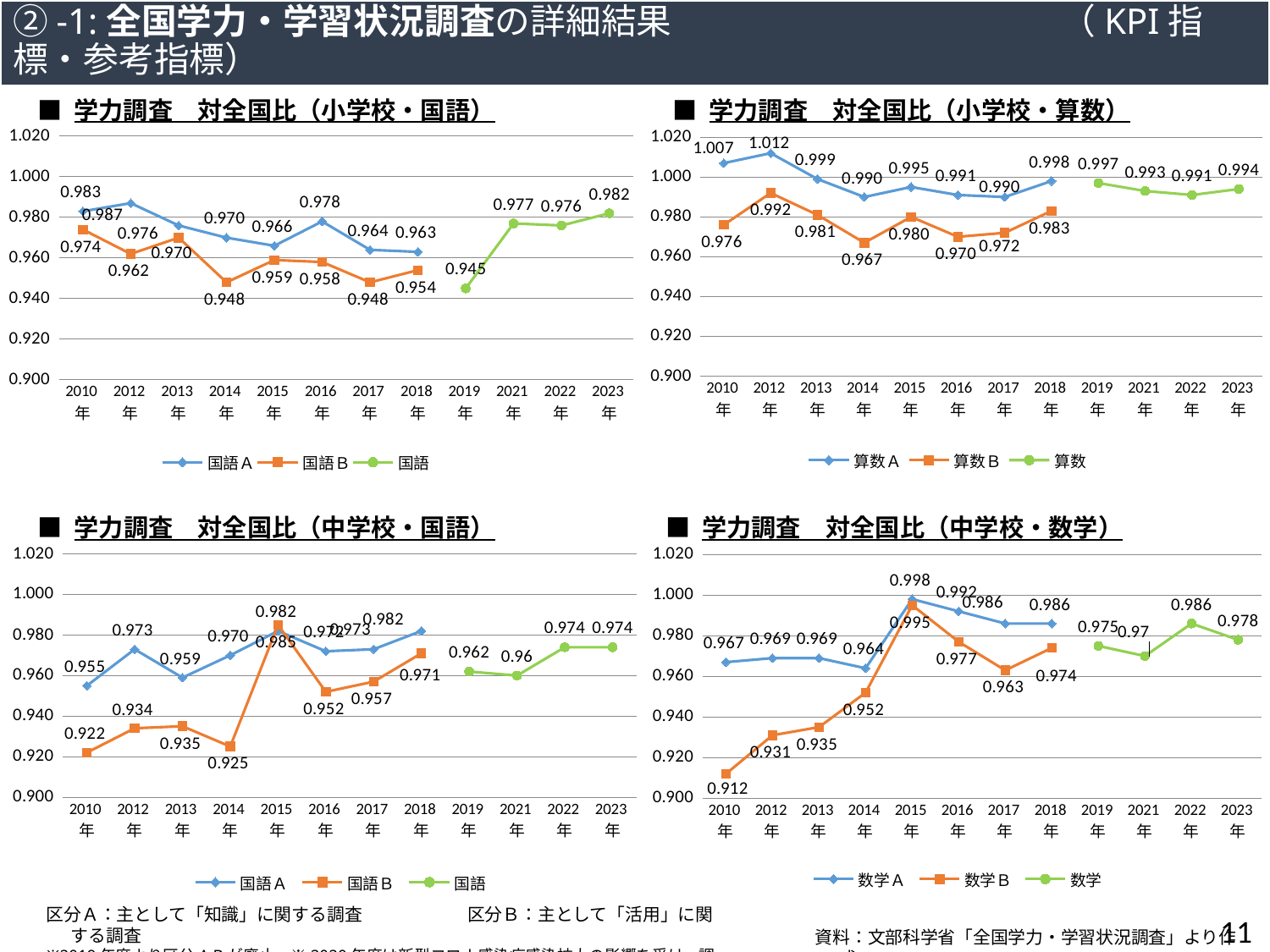
In the 中学校・数学 chart (bottom right), which is larger in 2017年, 数学A or 数学B? 数学A In the 中学校・国語 chart (bottom left), which year has the lowest value for 国語B? 2010年 What kind of chart is the 小学校・国語 chart (top left)? line chart In the 中学校・数学 chart (bottom right), what is the value of 数学B in 2010年? 0.912 In the 小学校・算数 chart (top right), what is the difference between 算数A and 算数B in 2014年? 0.023 In the 中学校・国語 chart (bottom left), what is the value of 国語A in 2015年? 0.982 In the 小学校・国語 chart (top left), what is the value of 国語A in 2012年? 0.987 In the 小学校・算数 chart (top right), which year has the highest value for 算数A? 2012年 How many series does the legend of the 小学校・算数 chart (top right) list? 3 How many years are shown on the x axis of the 中学校・国語 chart (bottom left)? 12 In the 小学校・国語 chart (top left), what is the value of 国語 in 2019年? 0.945 In the 中学校・数学 chart (bottom right), does 数学B rise or fall from 2010年 to 2015年? rise